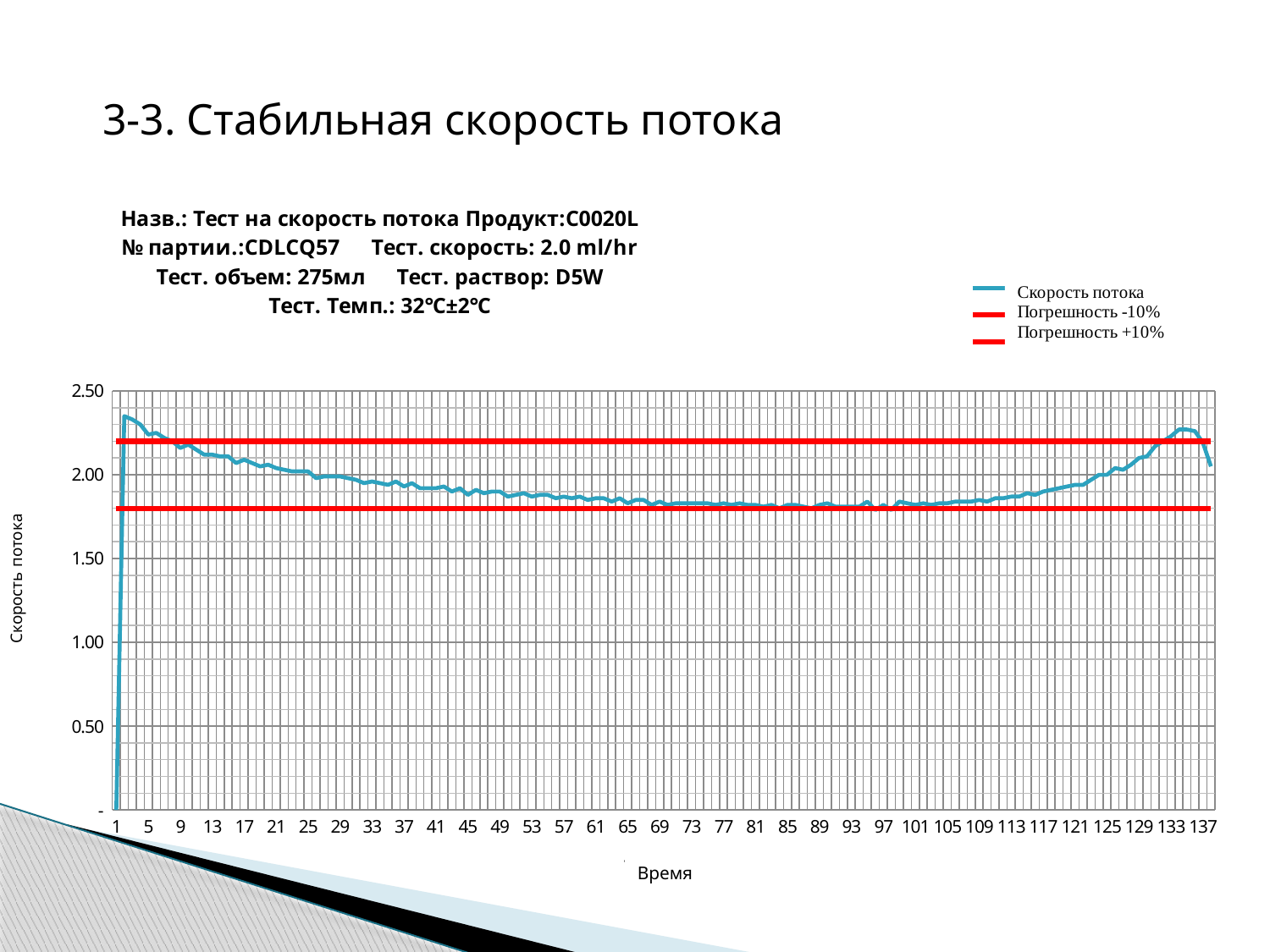
Is the flow rate (Скорость потока) value at time 45 greater or less than 1.50? greater Is the flow rate (Скорость потока) value at time 5 greater or less than 2.00? greater Is the flow rate (Скорость потока) value at time 89 greater or less than 2.00? less What are the three legend entries of the chart? Скорость потока, Погрешность -10%, Погрешность +10% What is the label of the x axis of the chart? Время How many series does the chart legend list? 3 Does the flow rate (Скорость потока) line rise or fall between time 101 and time 133? rise Which of the two values is larger: the flow rate at time 9 or the flow rate at time 77? time 9 Does the flow rate (Скорость потока) line rise or fall between time 5 and time 89? fall What kind of chart is shown on the slide? line chart